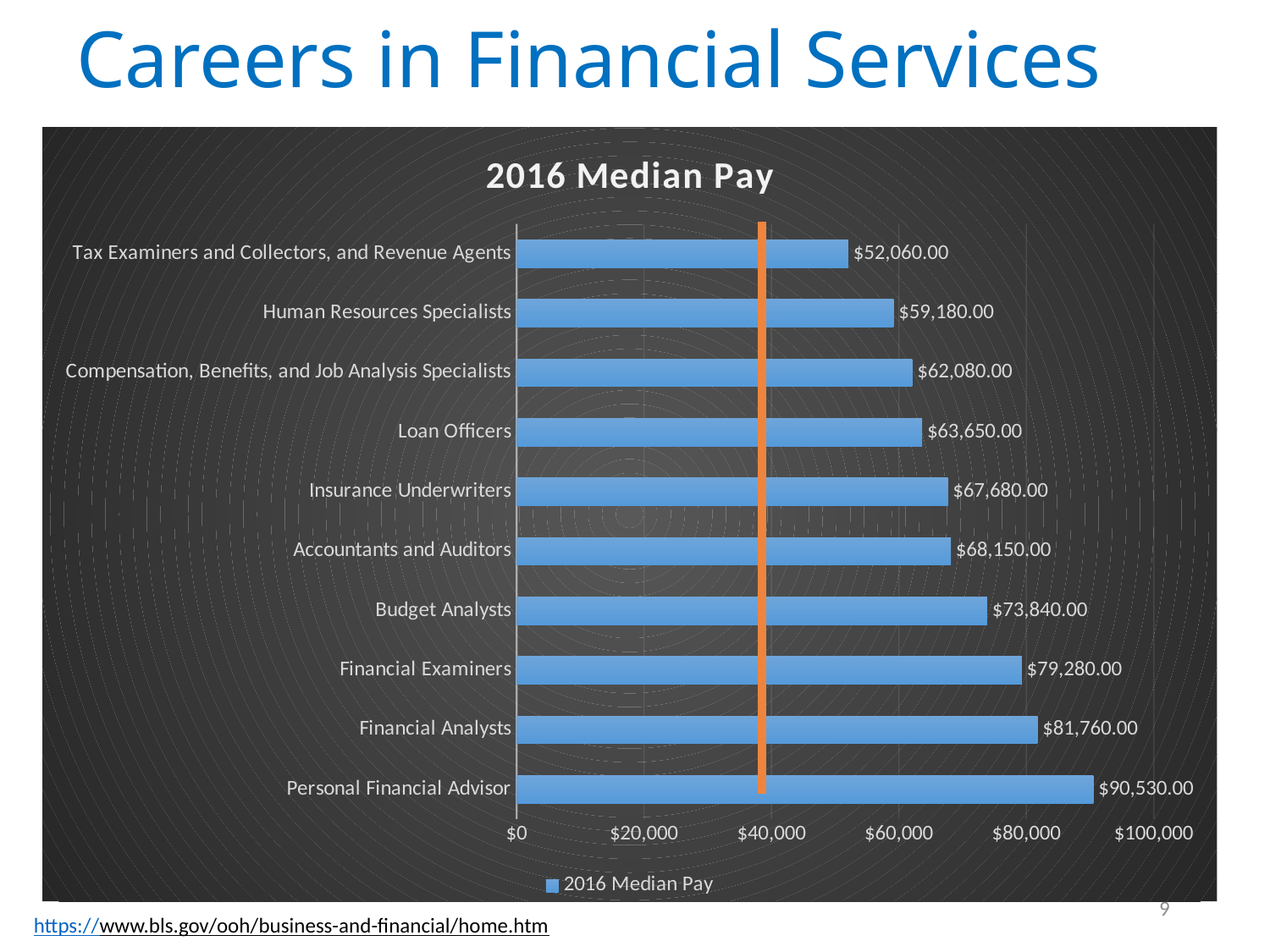
Which career has the lowest 2016 median pay? Tax Examiners and Collectors, and Revenue Agents What is the title of the chart? 2016 Median Pay What is the 2016 median pay for Loan Officers? $63,650.00 What kind of chart is shown on the slide? Bar chart Which has a higher 2016 median pay, Financial Examiners or Insurance Underwriters? Financial Examiners What is the 2016 median pay for Human Resources Specialists? $59,180.00 What is the difference in 2016 median pay between Personal Financial Advisor and Financial Analysts? $8,770.00 Which career has the highest 2016 median pay? Personal Financial Advisor How many careers are shown in the chart? 10 Is the 2016 median pay for Tax Examiners and Collectors, and Revenue Agents greater or less than $60,000? less What is the 2016 median pay for Financial Analysts? $81,760.00 What is the difference in 2016 median pay between Budget Analysts and Accountants and Auditors? $5,690.00